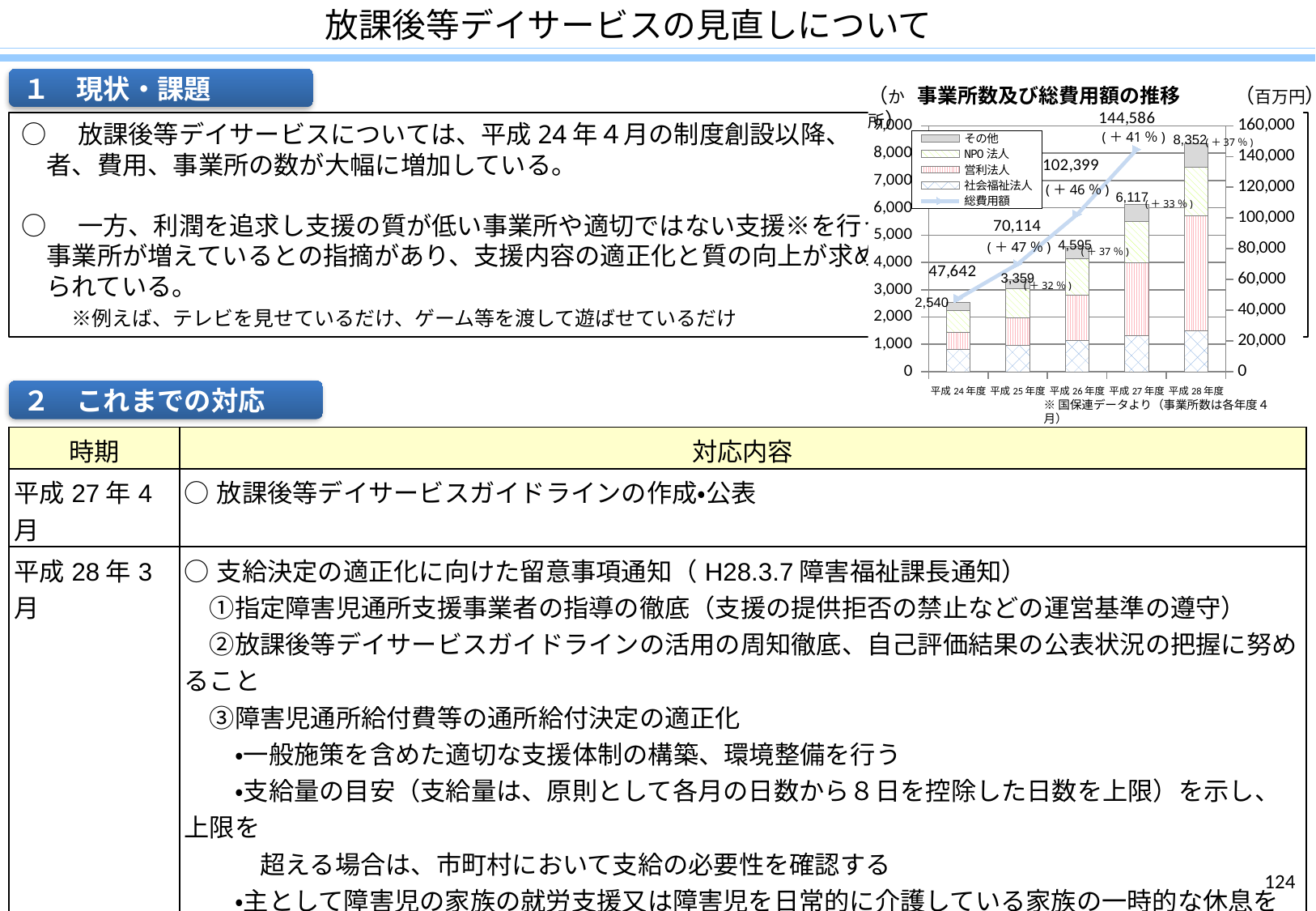
What is the total number of 事業所 shown for 平成24年度? 2,540 How many fiscal years (categories) are shown on the x axis of the chart? 5 What is the 総費用額 value shown for 平成26年度? 102,399 What is the difference in total 事業所 between 平成28年度 and 平成27年度? 2,235 How many entries does the chart's legend list? 5 Which fiscal year has the highest total number of 事業所? 平成28年度 Which fiscal year has the lowest total number of 事業所? 平成24年度 What type of chart is used to show the number of 事業所 by corporation type? stacked bar chart (with a line for 総費用額) What is the title of the chart on the slide? 事業所数及び総費用額の推移 What is the total number of 事業所 shown for 平成28年度? 8,352 Does the 総費用額 line rise or fall from 平成25年度 to 平成28年度? rise